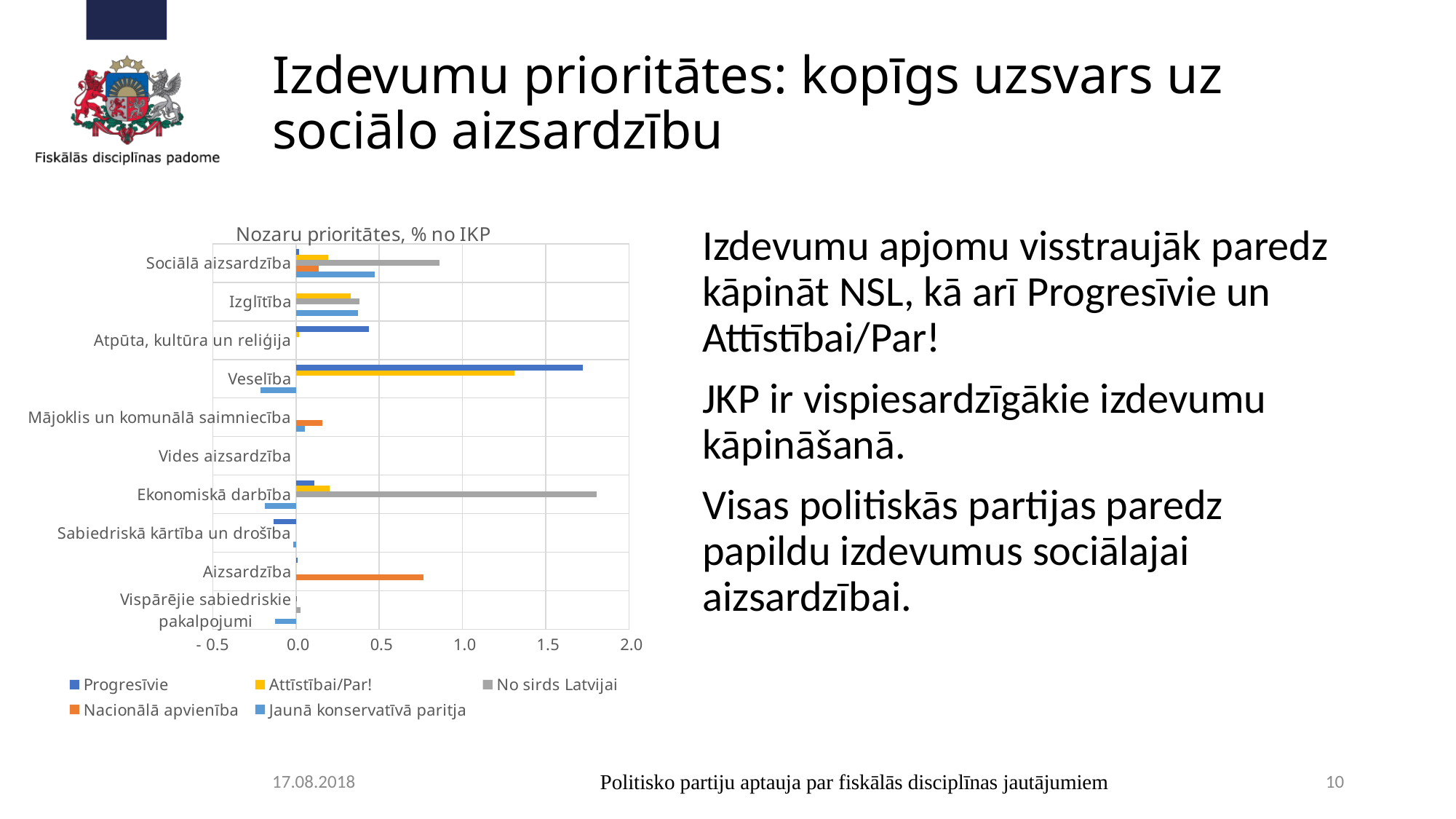
Which category has the highest value for the Nacionālā apvienība series? Aizsardzība Which category has the highest value for the No sirds Latvijai series? Ekonomiskā darbība Is the Nacionālā apvienība value for Aizsardzība greater or less than 0.5? greater What is the title of the chart? Nozaru prioritātes, % no IKP How many categories are shown on the chart's vertical axis? 10 Which series is shown in grey in the chart legend? No sirds Latvijai How many series does the chart legend list? 5 Is the Progresīvie value for Veselība greater or less than 1.5? greater What kind of chart is shown on the slide? bar chart Which category has the highest value for the Progresīvie series? Veselība Is the No sirds Latvijai value for Ekonomiskā darbība greater or less than 1.5? greater For Veselība, which series has the larger value: Progresīvie or Attīstībai/Par!? Progresīvie